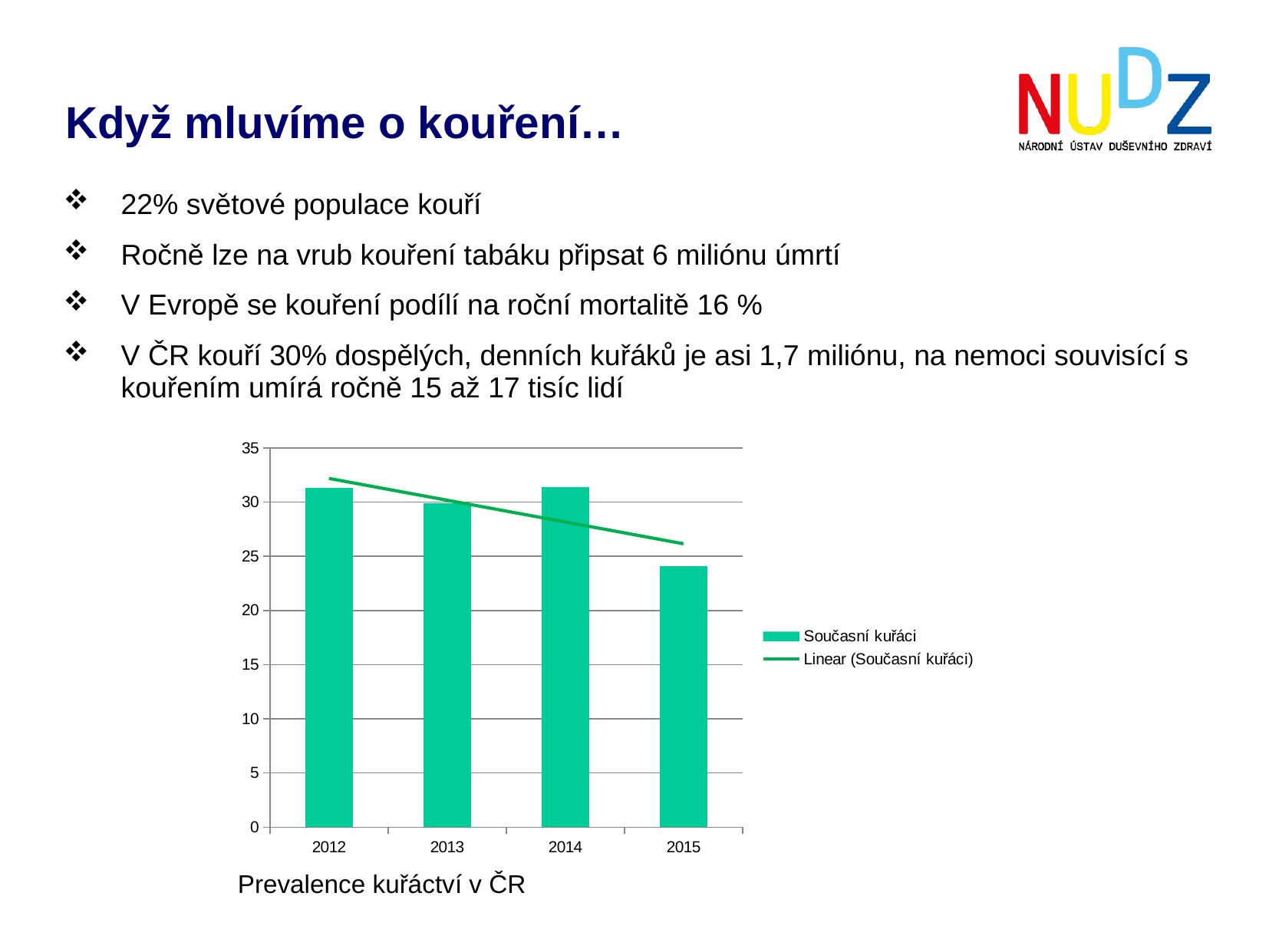
Does the linear trend line in the chart rise or fall from 2012 to 2015? fall How many entries does the chart legend list? 2 Is the value for 2012 greater or less than 30? greater Is the value for 2013 greater or less than 25? greater Is the value for 2014 greater or less than 30? greater What kind of chart is shown on the slide? bar chart Which year has the lowest value for Současní kuřáci? 2015 How many years are shown on the x axis of the chart? 4 Which year has the larger value, 2012 or 2015? 2012 Which year has the larger value, 2013 or 2015? 2013 What caption is written below the chart? Prevalence kuřáctví v ČR